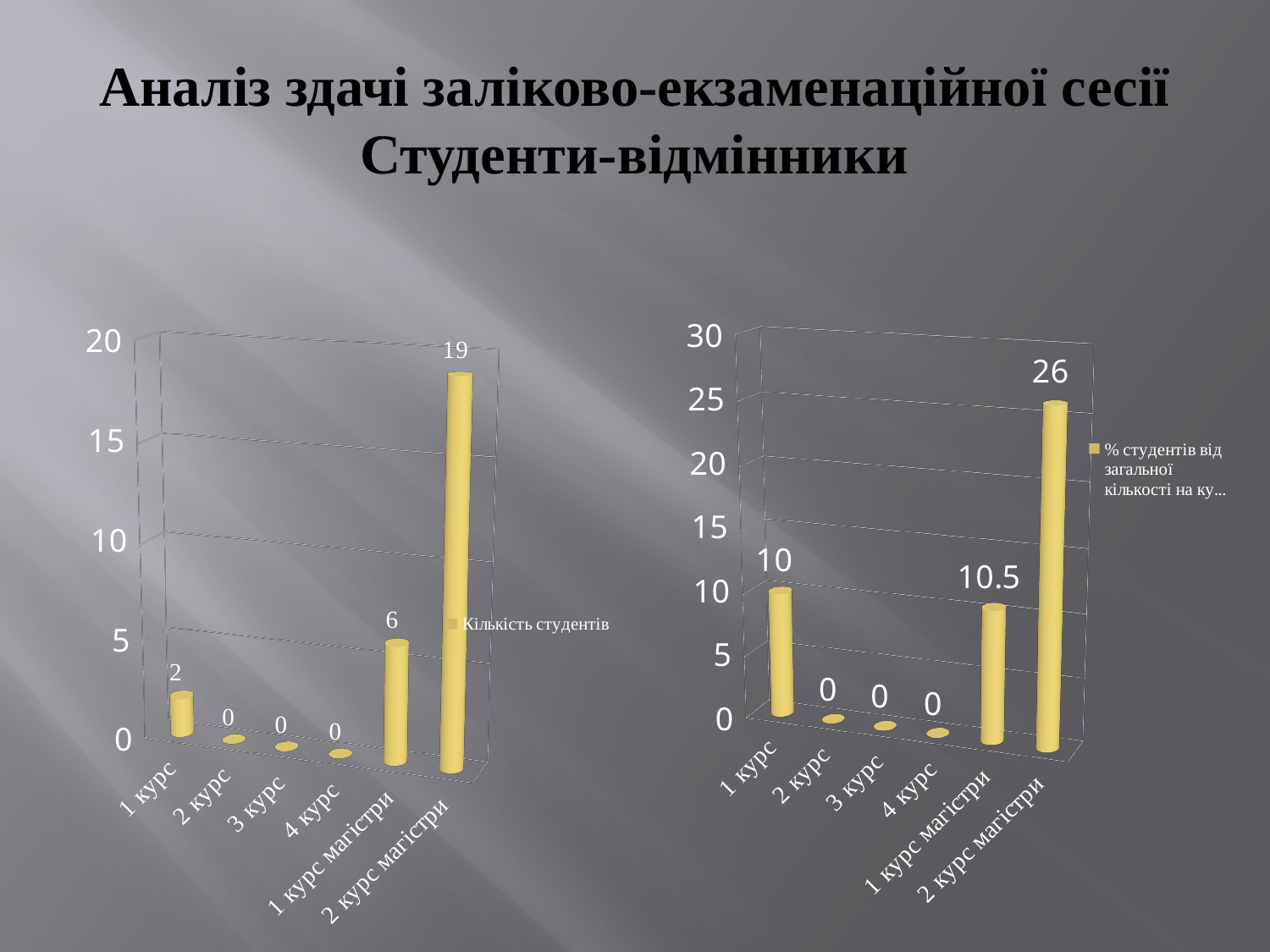
What kind of chart is the left chart (Кількість студентів)? Bar chart In the right chart (% студентів), which category has the highest value? 2 курс магістри In the left chart (Кількість студентів), which category has the highest value? 2 курс магістри In the right chart (% студентів), what is the difference between the values for 2 курс магістри and 1 курс? 16 In the left chart (Кількість студентів), what is the value for 1 курс? 2 In the right chart (% студентів), what is the value for 1 курс магістри? 10.5 In the left chart (Кількість студентів), what is the value for 2 курс магістри? 19 In the left chart (Кількість студентів), what is the value for 1 курс магістри? 6 In the left chart (Кількість студентів), how many categories are shown on the x axis? 6 In the left chart (Кількість студентів), what is the difference between the values for 2 курс магістри and 1 курс магістри? 13 In the right chart (% студентів), what is the value for 2 курс магістри? 26 In the right chart (% студентів), what is the value for 1 курс? 10